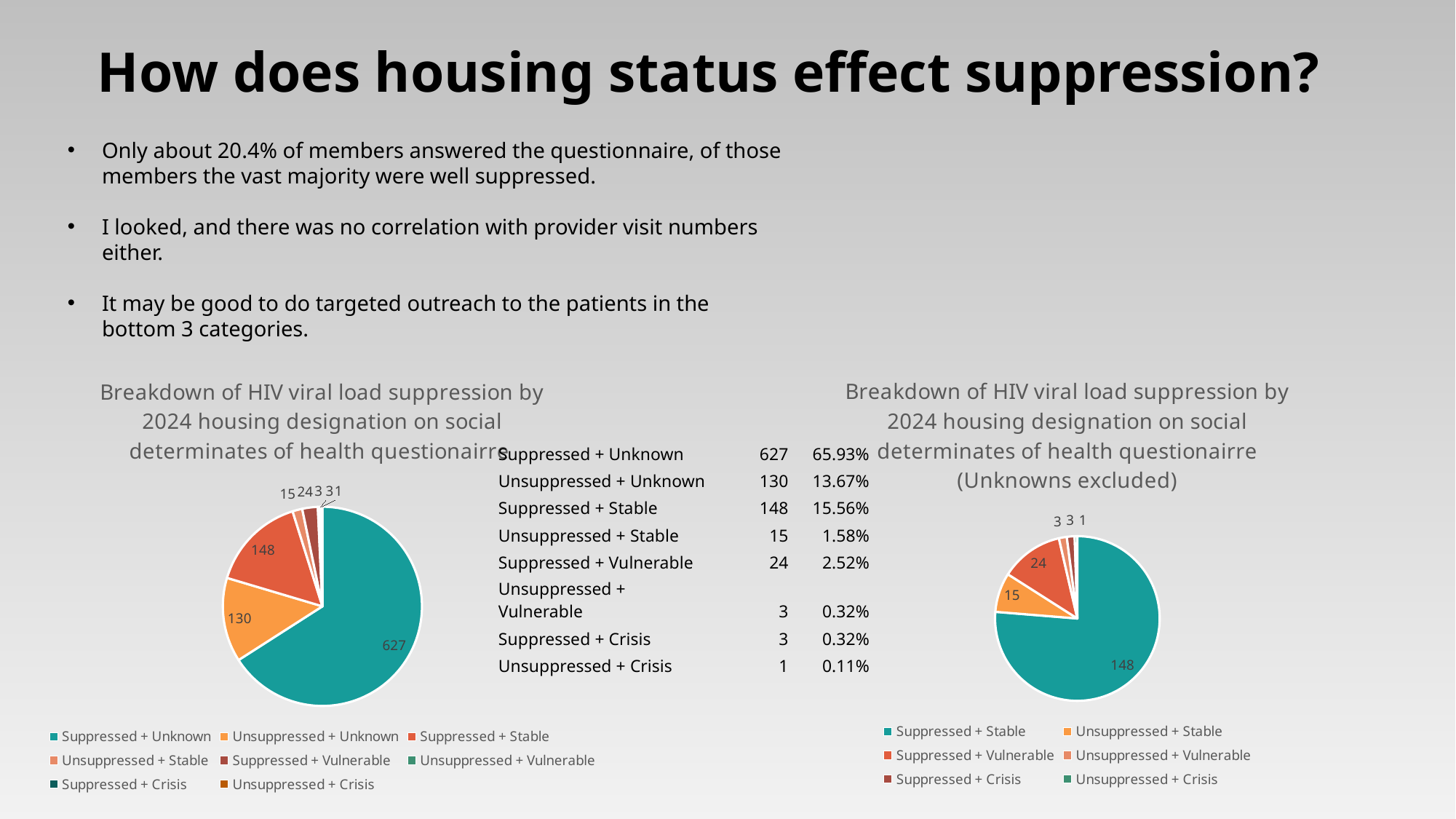
In the left pie chart, what is the value for Unsuppressed + Unknown? 130 In the right pie chart (Unknowns excluded), which category has the largest slice? Suppressed + Stable In the left pie chart, what is the difference between the values for Suppressed + Stable and Unsuppressed + Unknown? 18 In the left pie chart, which category has the largest slice? Suppressed + Unknown In the right pie chart (Unknowns excluded), what is the value for Suppressed + Stable? 148 What kind of charts are shown on the slide? Pie charts In the left pie chart, which is larger: Suppressed + Stable or Unsuppressed + Unknown? Suppressed + Stable In the left pie chart, which category has the smallest slice? Unsuppressed + Crisis In the left pie chart, what share of the total does Suppressed + Unknown represent? 65.93% In the left pie chart, what is the value for Suppressed + Unknown? 627 How many categories does the legend of the left pie chart list? 8 In the right pie chart (Unknowns excluded), what is the value for Suppressed + Vulnerable? 24